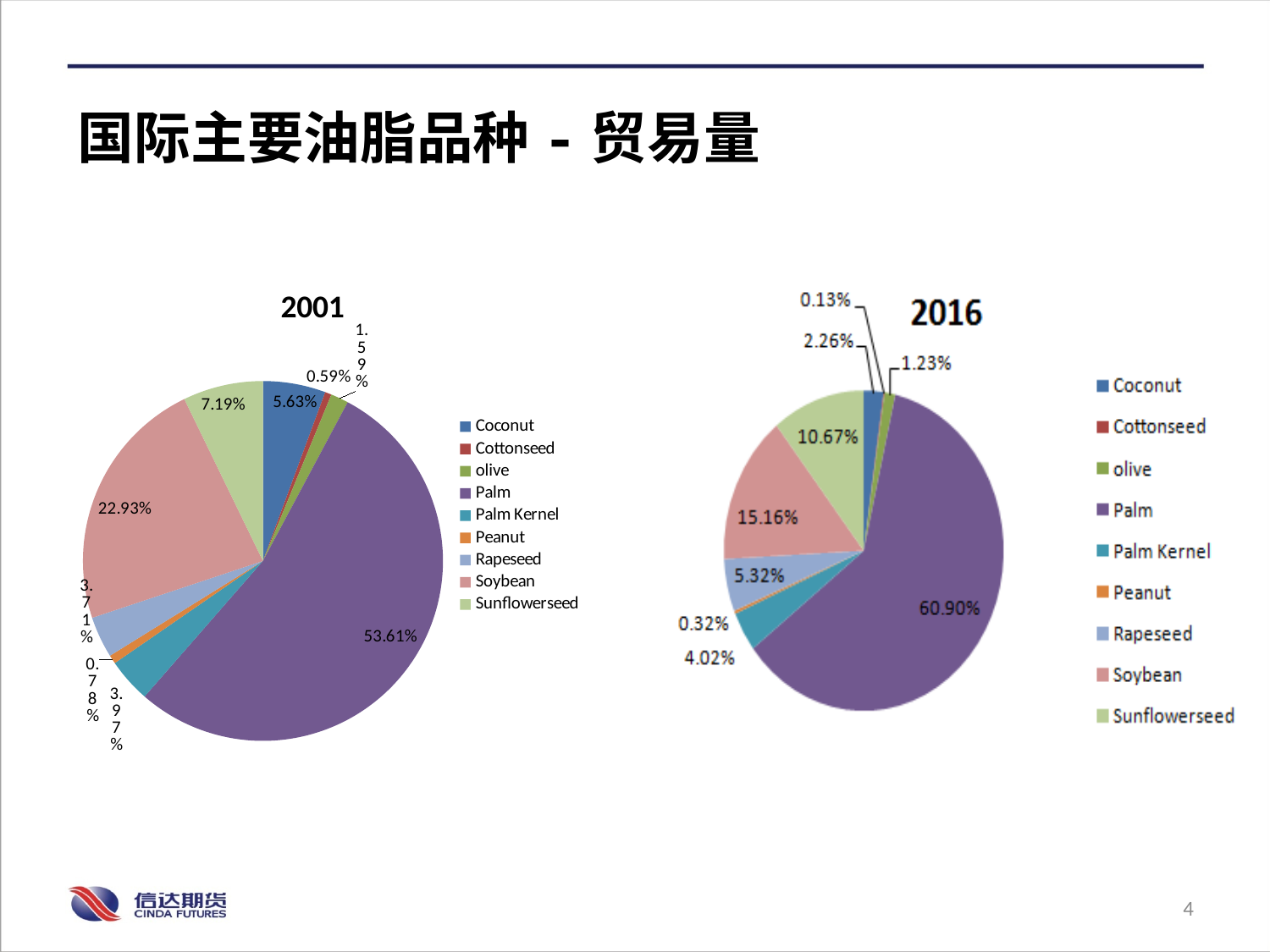
In the 2001 pie chart, what share does Coconut have? 5.63% In the 2001 pie chart, what share does Palm have? 53.61% What is the difference between Palm's share in 2016 and in 2001? 7.29% In the 2016 pie chart, which category has the smallest share? Cottonseed In the 2016 pie chart, which is larger, Rapeseed or Palm Kernel? Rapeseed In the 2016 pie chart, what share does Palm have? 60.90% In the 2001 pie chart, which category has the smallest share? Cottonseed In the 2016 pie chart, what share does Sunflowerseed have? 10.67% What kind of chart is used for the 2001 data? Pie chart In the 2001 pie chart, what share does Soybean have? 22.93% In the 2016 pie chart, which category has the largest share? Palm How many categories does the legend of the 2001 pie chart list? 9